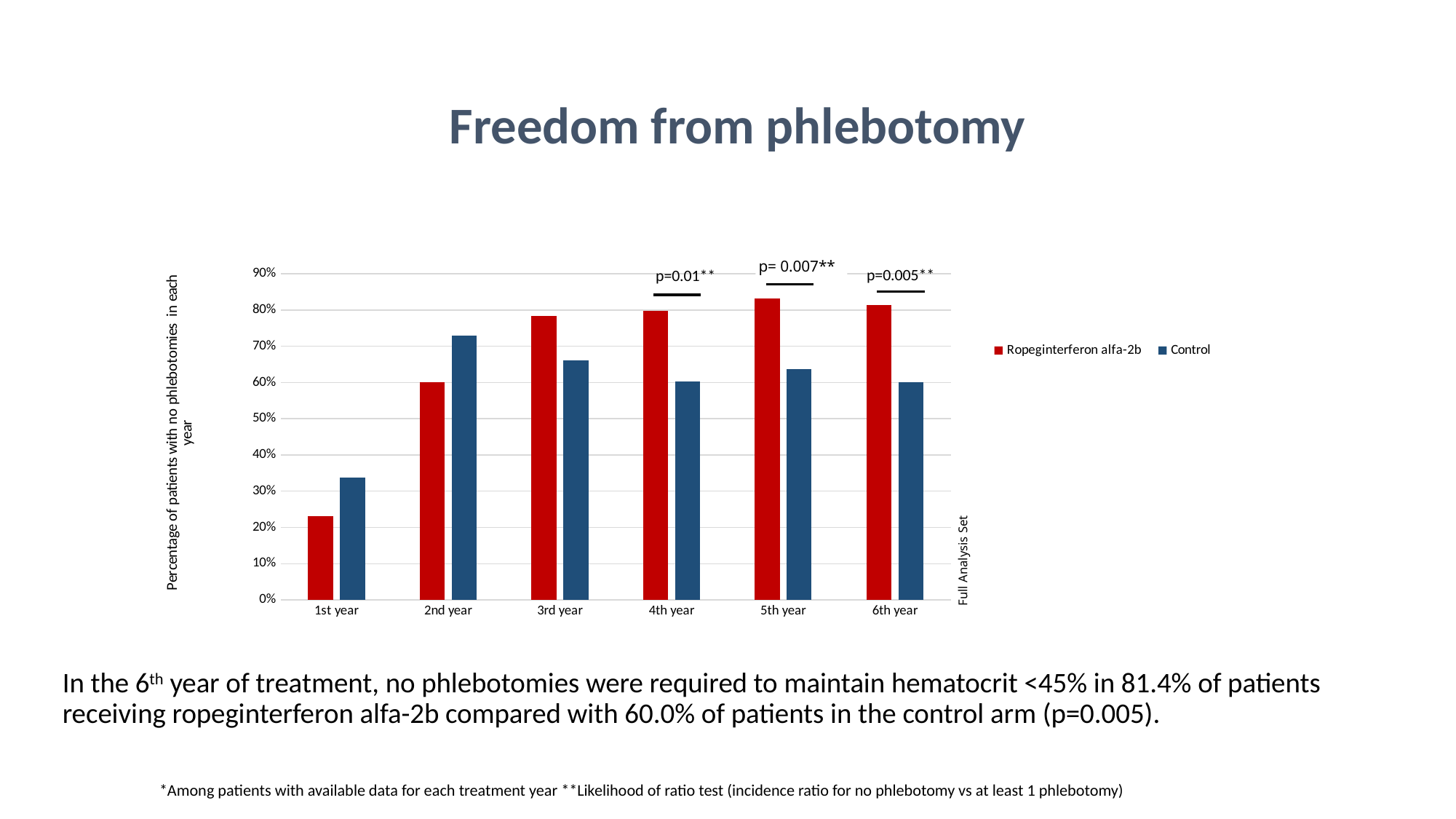
Is the Control value for the 2nd year greater or less than 70%? greater In which year is the Control value highest? 2nd year In the 1st year, which is larger: Ropeginterferon alfa-2b or Control? Control Does the Ropeginterferon alfa-2b value rise or fall from the 1st year to the 3rd year? rise How many series does the legend list? 2 According to the slide, what percentage of patients in the control arm required no phlebotomies in the 6th year? 60.0% Is the Ropeginterferon alfa-2b value for the 1st year greater or less than 30%? less In which year is the Ropeginterferon alfa-2b value lowest? 1st year What kind of chart is shown on the slide? bar chart According to the slide, what percentage of patients receiving ropeginterferon alfa-2b required no phlebotomies in the 6th year? 81.4% How many treatment years are shown on the x axis? 6 What p-value is shown above the 4th year bars? p=0.01**